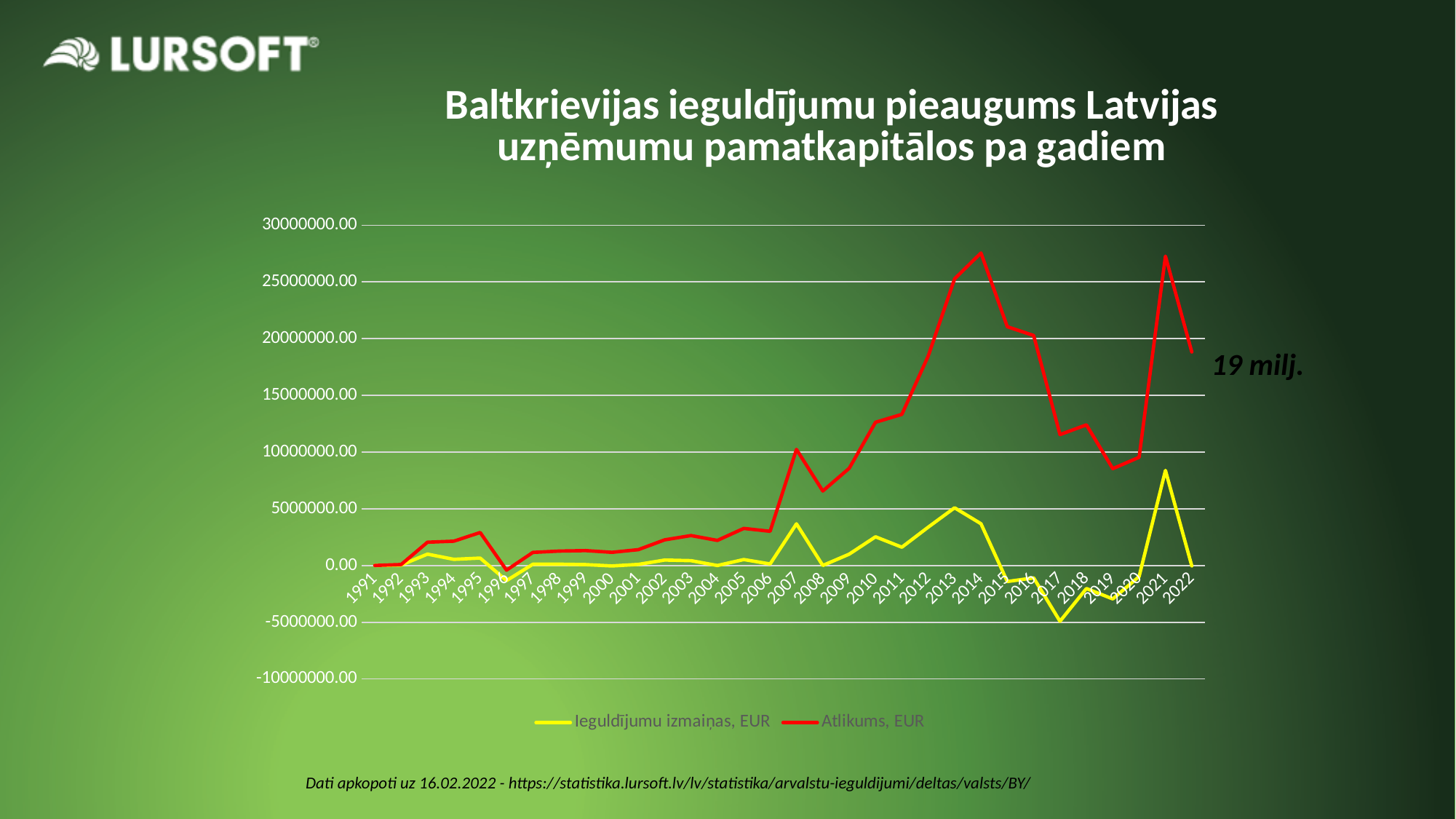
What kind of chart is shown on the slide? line chart Is the value for Atlikums, EUR in 2014 greater or less than 25000000.00? greater How many years are plotted along the x axis? 32 What annotation is printed next to the end of the red line? 19 milj. Is the value for Ieguldījumu izmaiņas, EUR in 2021 greater or less than 5000000.00? greater Which is larger for Atlikums, EUR: the value in 2014 or the value in 2017? 2014 Is the value for Atlikums, EUR in 2019 greater or less than 10000000.00? less In which year is the value of Ieguldījumu izmaiņas, EUR lowest? 2017 In which year is the value of Ieguldījumu izmaiņas, EUR highest? 2021 Does the Atlikums, EUR line rise or fall from 2014 to 2017? fall Which colour is used for the Atlikums, EUR series? red How many series does the legend list? 2